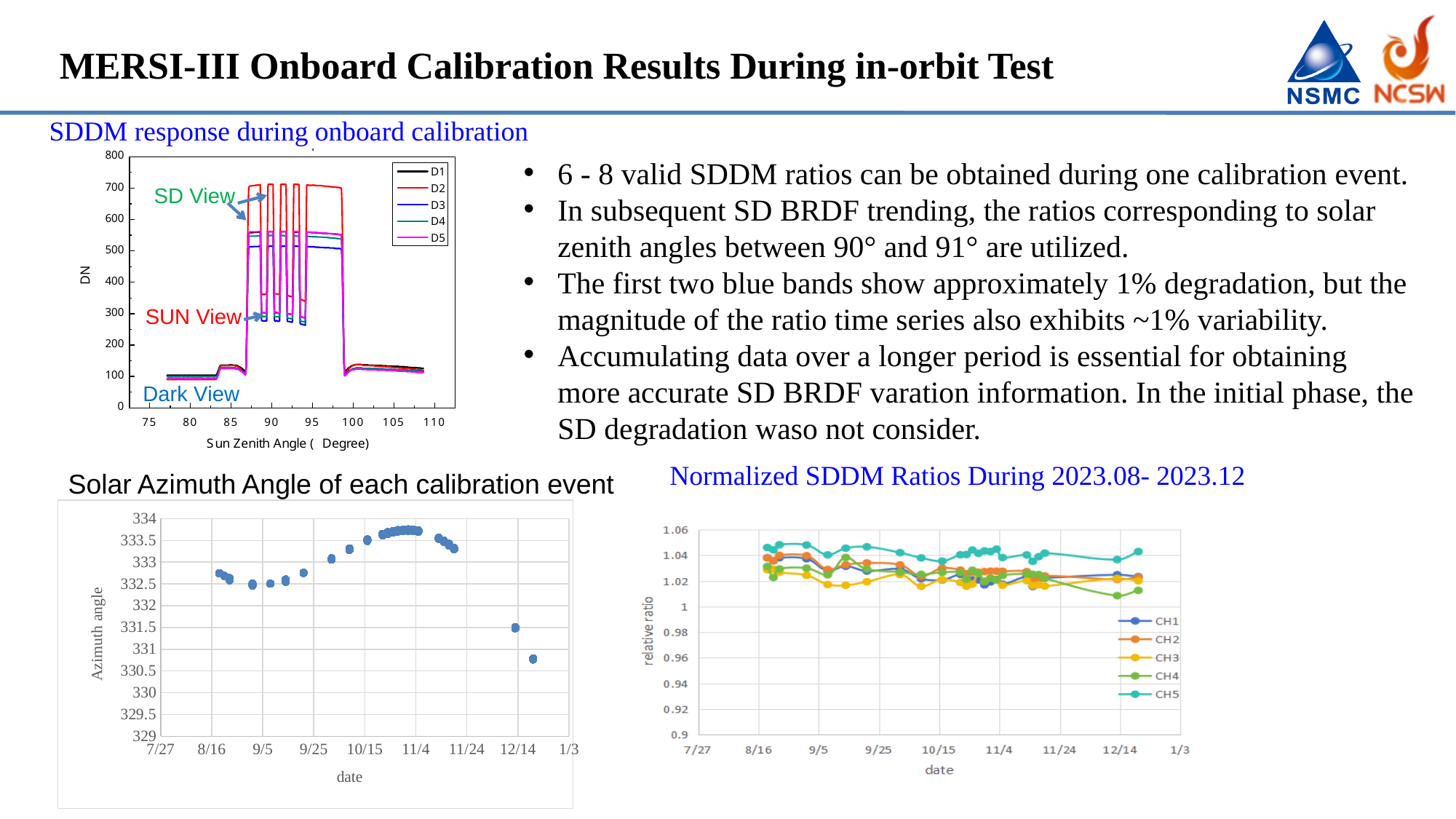
In the 'SDDM response during onboard calibration' chart, what is the x-axis title? Sun Zenith Angle (Degree) What kind of chart is the 'SDDM response during onboard calibration' chart? line chart In the 'Solar Azimuth Angle of each calibration event' chart, is the azimuth angle of the last point (after 12/14) greater or less than 331? less In the 'Normalized SDDM Ratios During 2023.08-2023.12' chart, which channel has the highest relative ratio for most of the period? CH5 In the 'Solar Azimuth Angle of each calibration event' chart, are the points around 11/4 greater or less than 333.5? greater In the 'Solar Azimuth Angle of each calibration event' chart, what is the y-axis label? Azimuth angle In the 'SDDM response during onboard calibration' chart, how many series does the legend list? 5 In the 'Normalized SDDM Ratios During 2023.08-2023.12' chart, how many channels does the legend list? 5 In the 'SDDM response during onboard calibration' chart, is the peak DN of D2 greater or less than 600? greater In the 'SDDM response during onboard calibration' chart, which series reaches the highest DN in the SD View region? D2 What kind of chart is the 'Solar Azimuth Angle of each calibration event' chart? scatter chart